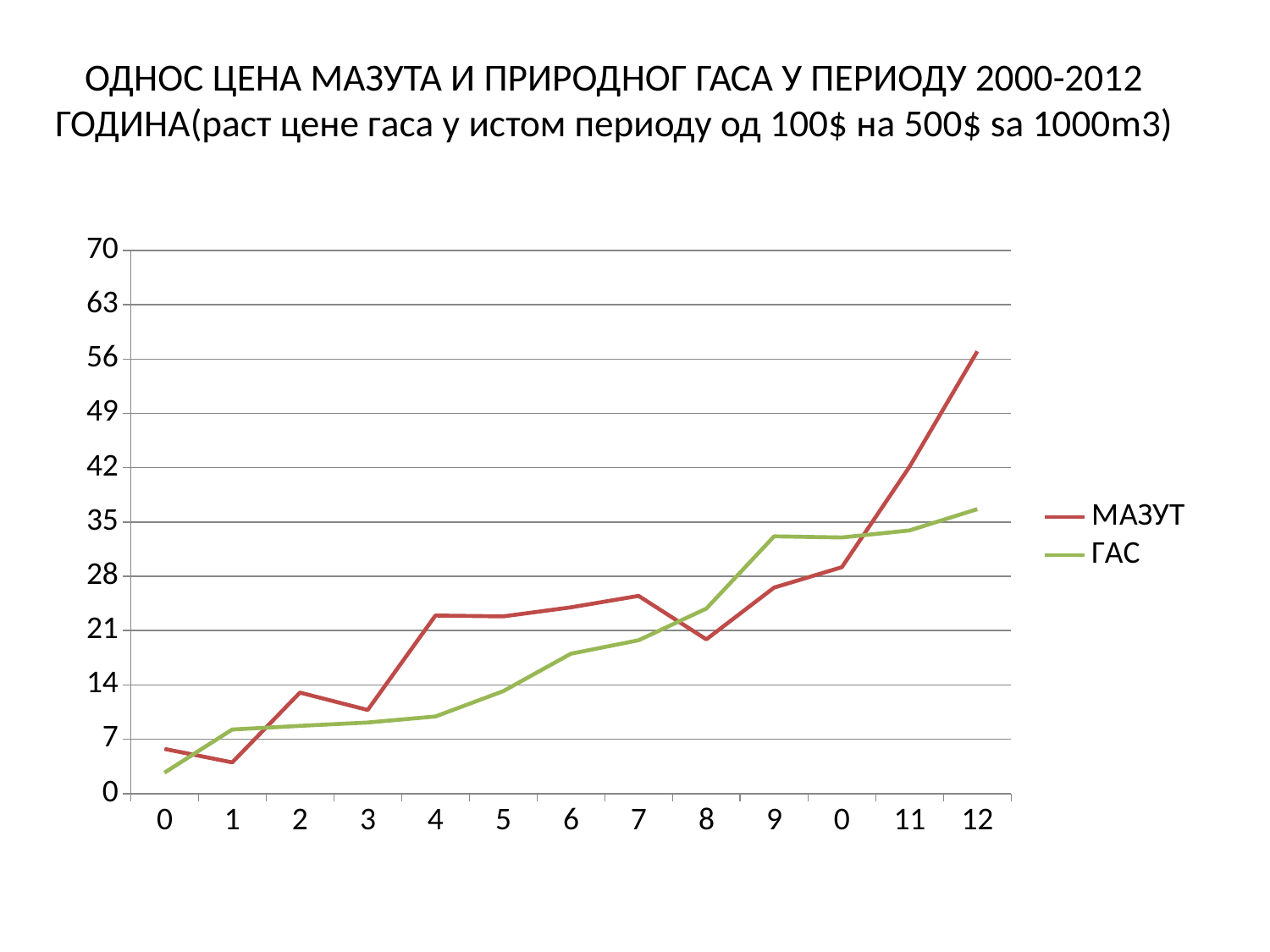
How many series does the legend list? 2 Does the ГАС series generally rise or fall from left to right along the x axis? rise Is the value of МАЗУТ at x = 12 greater or less than 49? greater At which x-axis point does the МАЗУТ series reach its highest value? 12 How many points are plotted along the x axis for each series? 13 At x = 12, which series has the larger value, МАЗУТ or ГАС? МАЗУТ What kind of chart is shown on the slide? line chart Which colour is used for the ГАС line? green Is the value of ГАС at x = 0 greater or less than 7? less What are the two series named in the legend? МАЗУТ and ГАС Is the value of ГАС at x = 9 greater or less than 28? greater At x = 9, which series has the larger value, МАЗУТ or ГАС? ГАС